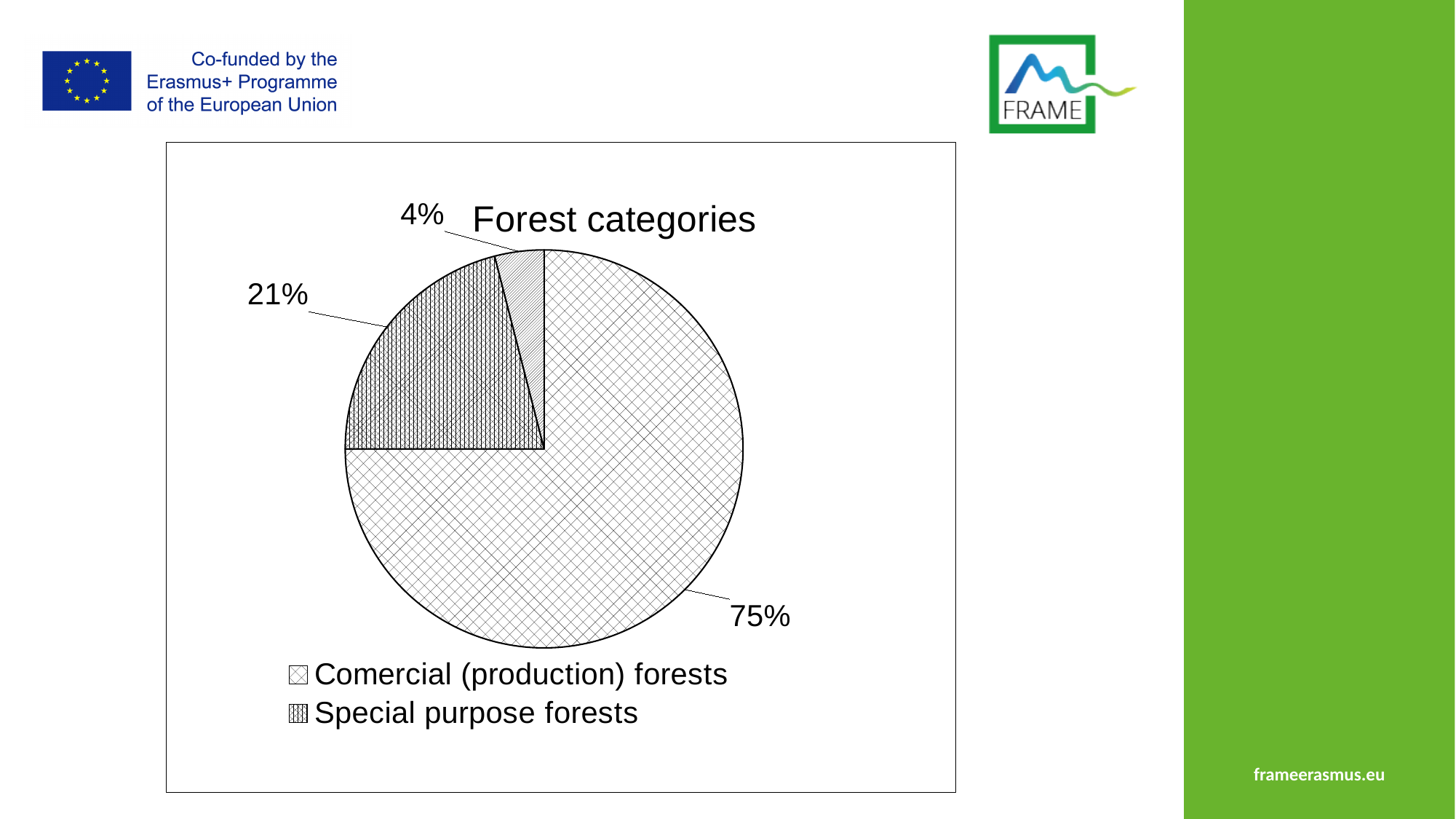
Which is larger, the share for Comercial (production) forests or the share for Special purpose forests? Comercial (production) forests What is the smallest percentage shown on the pie chart? 4% Which category has the largest slice of the pie? Comercial (production) forests How many entries does the legend list? 2 What is the second legend entry listed below the pie chart? Special purpose forests How many slices does the pie chart have? 3 What share of the pie is Comercial (production) forests? 75% What share of the pie is Special purpose forests? 21% What kind of chart is shown on the slide? pie chart What is the title of the chart? Forest categories Is the share for Special purpose forests greater or less than 50%? less What is the difference in percentage points between Comercial (production) forests and Special purpose forests? 54